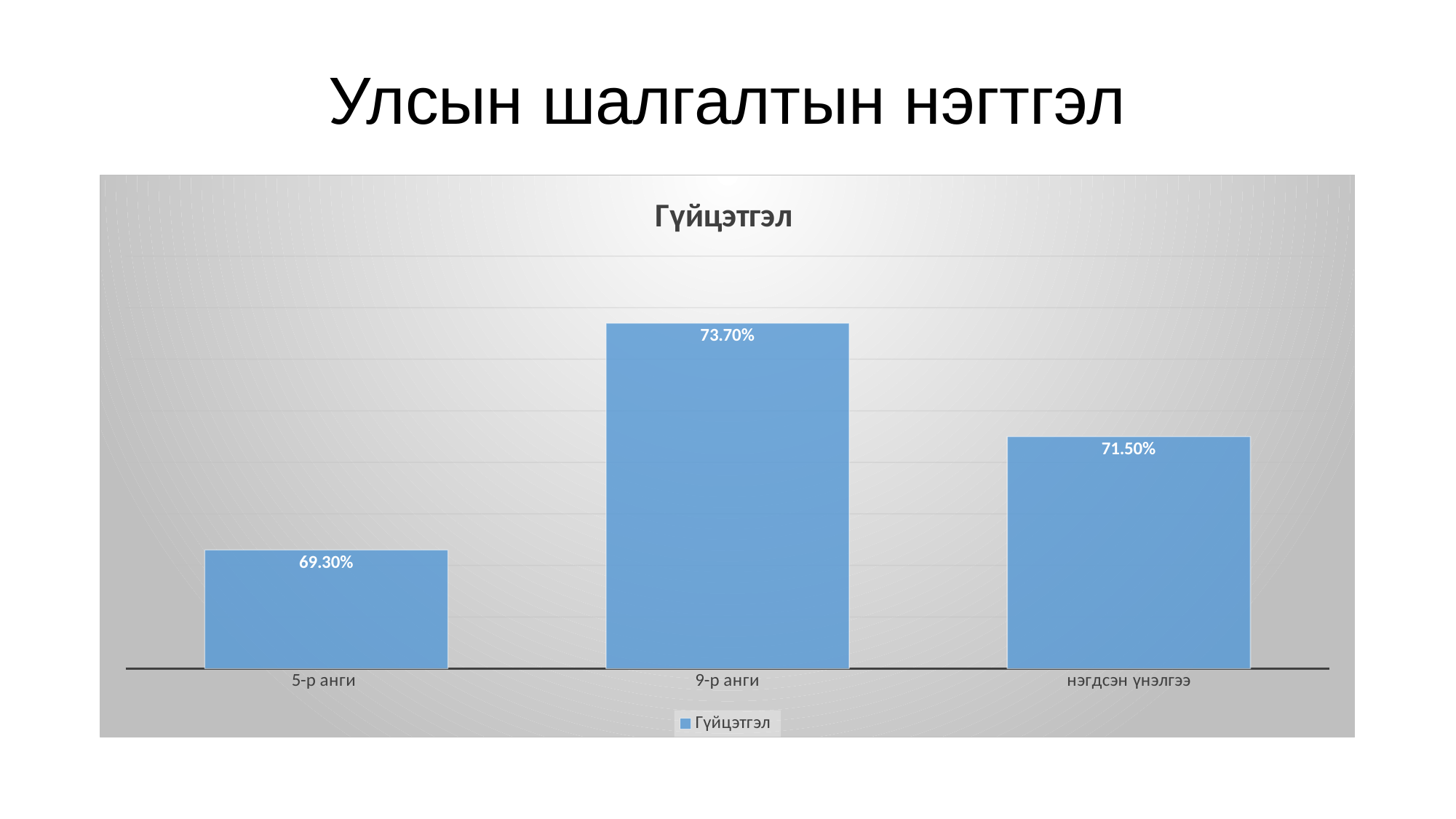
What kind of chart is shown on the slide? Bar chart What is the value for 5-р анги? 69.30% Which category has the highest value? 9-р анги Which category has the lowest value? 5-р анги What is the value for 9-р анги? 73.70% How many categories are shown on the chart? 3 How many series does the legend list? 1 What is the value for нэгдсэн үнэлгээ? 71.50% What is the difference between the values for нэгдсэн үнэлгээ and 5-р анги? 2.20% What is the title of the chart? Гүйцэтгэл Which is larger, the value for 9-р анги or the value for нэгдсэн үнэлгээ? 9-р анги What is the difference between the values for 9-р анги and 5-р анги? 4.40%